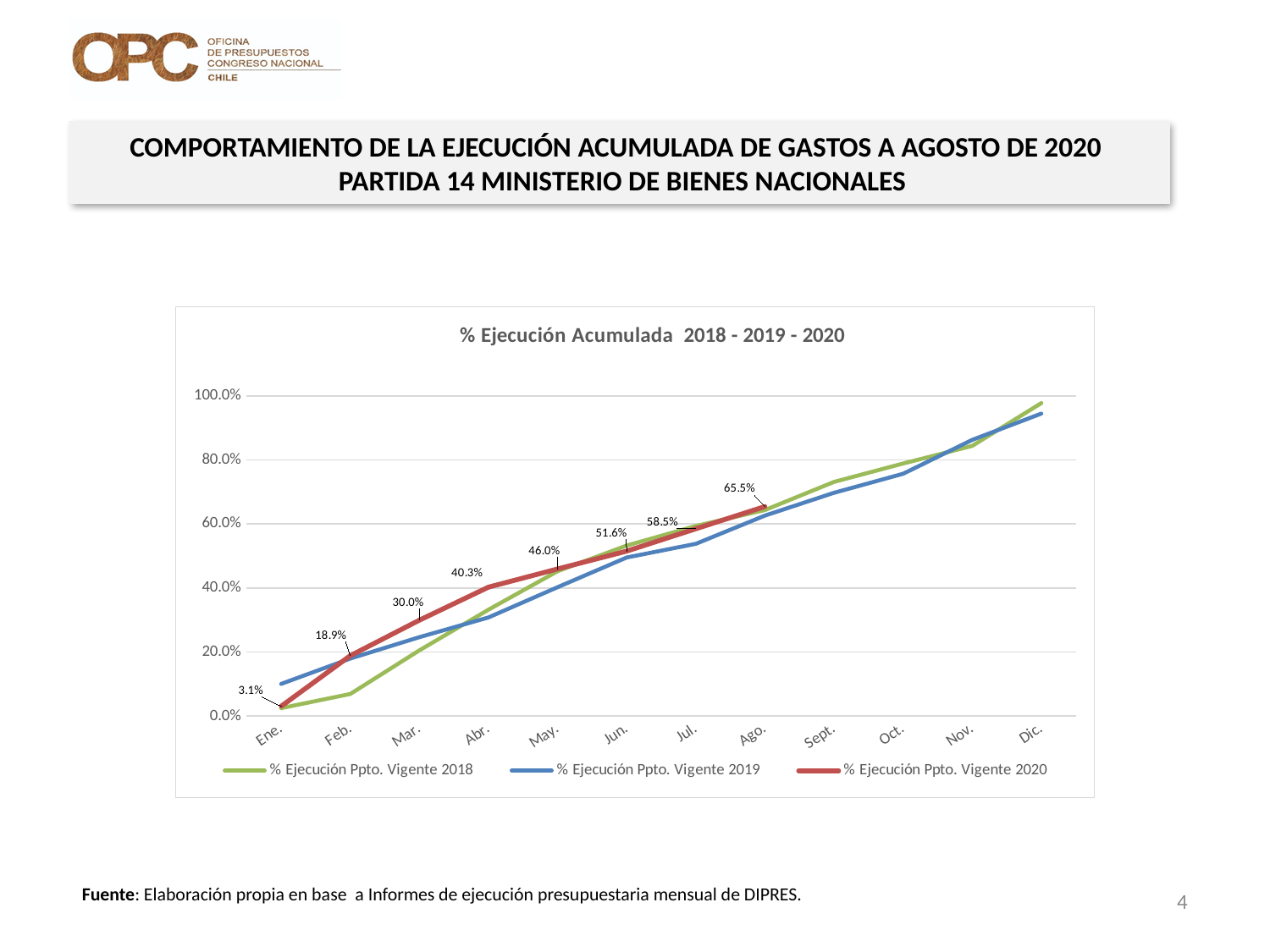
What is the difference between the % Ejecución Ppto. Vigente 2020 values for Ago. and Jul.? 7.0% What is the value for % Ejecución Ppto. Vigente 2020 in Mar.? 30.0% What is the difference between the % Ejecución Ppto. Vigente 2020 values for Abr. and Mar.? 10.3% Is the value for % Ejecución Ppto. Vigente 2018 in Dic. greater or less than 80.0%? greater How many series does the legend list? 3 What is the value for % Ejecución Ppto. Vigente 2020 in Ene.? 3.1% Which month has the highest labelled value for % Ejecución Ppto. Vigente 2020? Ago. What is the value for % Ejecución Ppto. Vigente 2020 in May.? 46.0% Which month has the lowest labelled value for % Ejecución Ppto. Vigente 2020? Ene. What is the value for % Ejecución Ppto. Vigente 2020 in Ago.? 65.5% What kind of chart is shown? Line chart How many months are shown on the x axis? 12